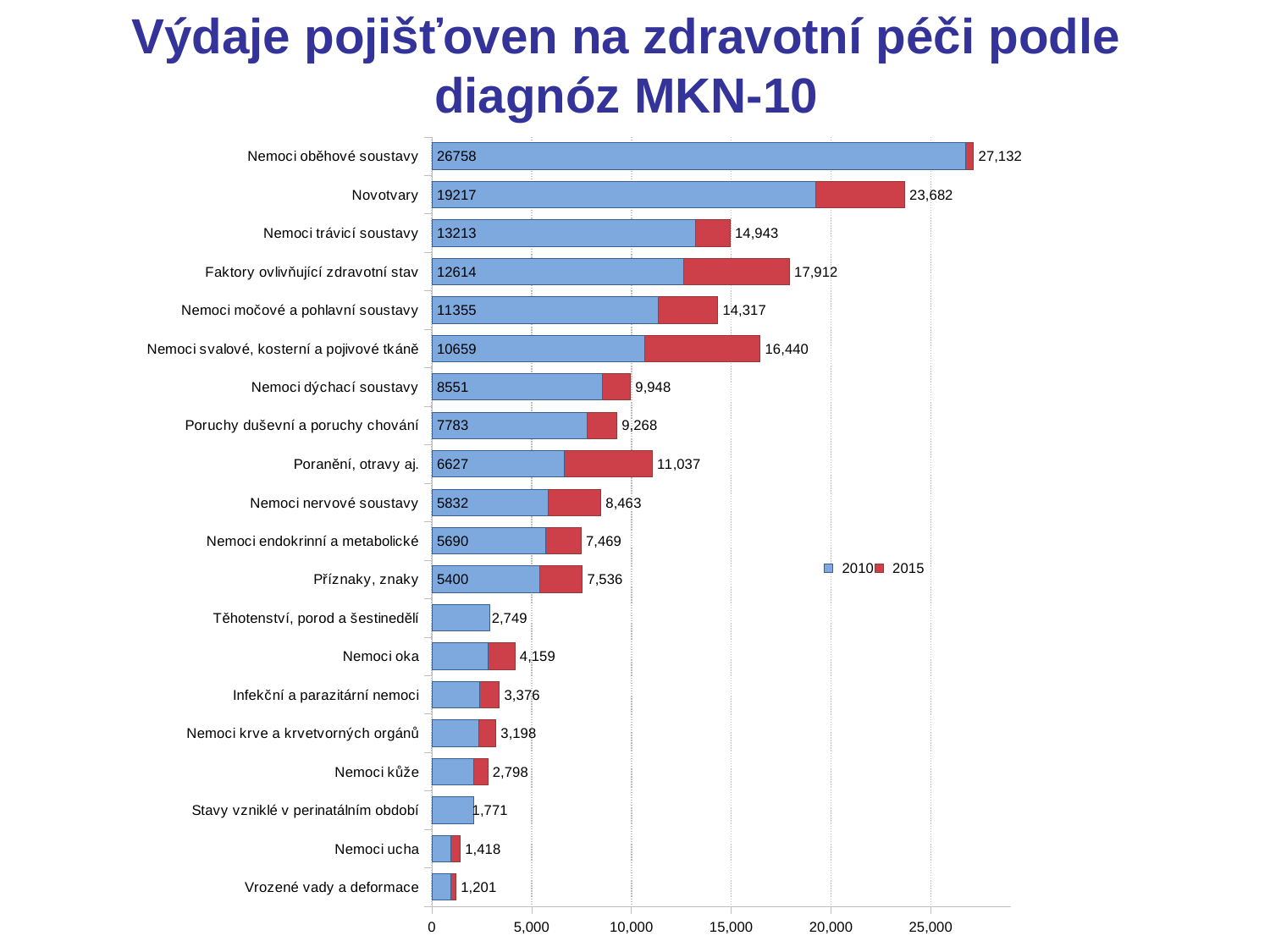
Which has the larger 2015 value: Faktory ovlivňující zdravotní stav or Nemoci svalové, kosterní a pojivové tkáně? Faktory ovlivňující zdravotní stav What is the 2010 value for Novotvary? 19217 Which category has the lowest 2015 value? Vrozené vady a deformace Is the 2010 value for Nemoci oka greater or less than 5,000? less How many categories are shown on the chart? 20 How many series does the legend list? 2 Which category has the highest 2015 value? Nemoci oběhové soustavy What is the 2015 value for Poranění, otravy aj.? 11,037 What is the difference between the 2015 and 2010 values for Nemoci oběhové soustavy? 374 What is the difference between the 2015 and 2010 values for Novotvary? 4,465 What is the 2010 value for Nemoci dýchací soustavy? 8551 What is the 2015 value for Nemoci trávicí soustavy? 14,943